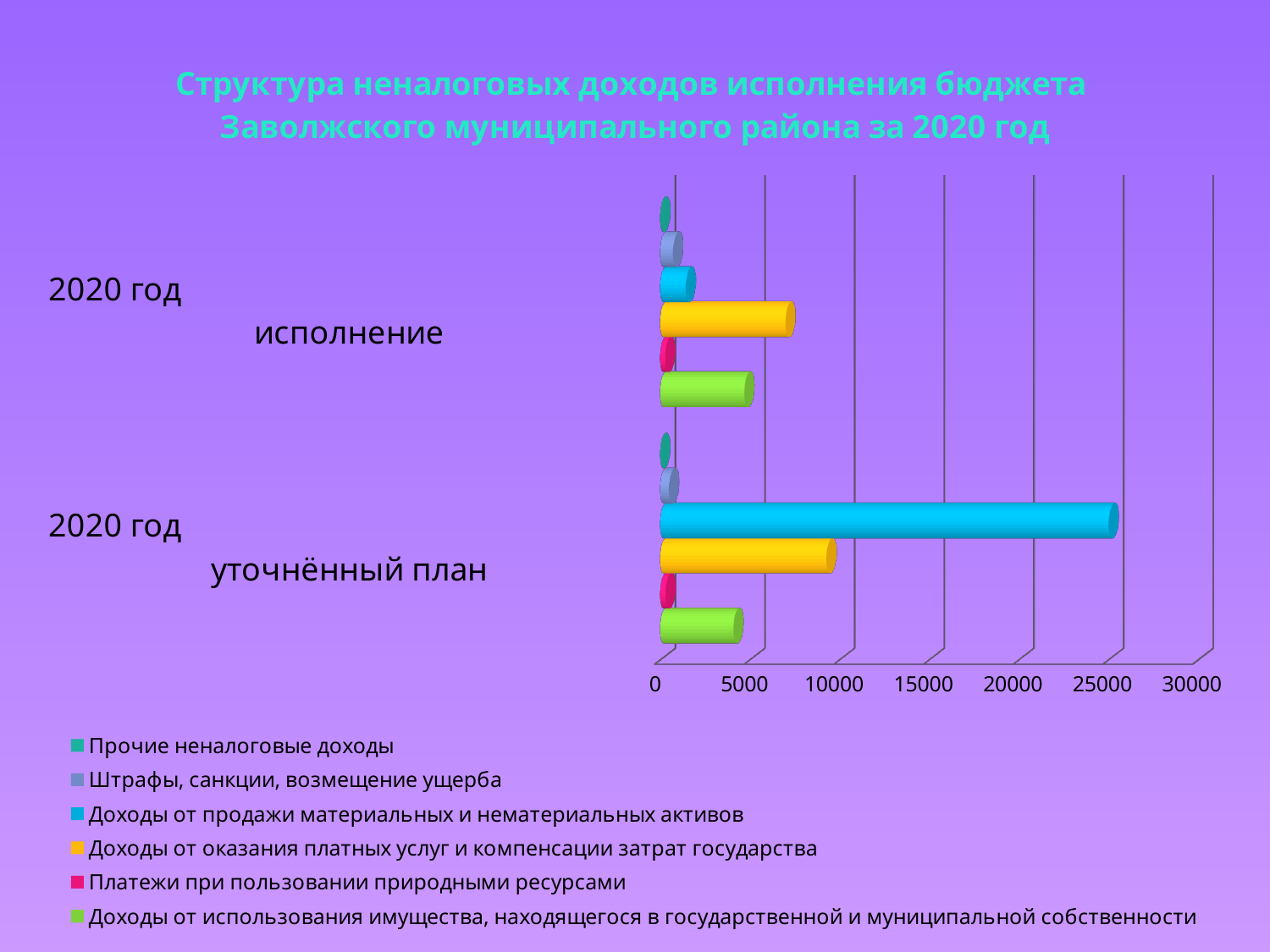
Which is larger: "Доходы от продажи материальных и нематериальных активов" for "2020 год уточнённый план" or for "2020 год исполнение"? 2020 год уточнённый план Which is larger for "2020 год исполнение": "Доходы от оказания платных услуг и компенсации затрат государства" or "Доходы от использования имущества, находящегося в государственной и муниципальной собственности"? Доходы от оказания платных услуг и компенсации затрат государства Which series has the longest bar for "2020 год уточнённый план"? Доходы от продажи материальных и нематериальных активов How many categories are shown on the vertical axis of the chart? 2 Is the value for "Доходы от оказания платных услуг и компенсации затрат государства" in "2020 год исполнение" greater or less than 10000? less What is the title of the chart? Структура неналоговых доходов исполнения бюджета Заволжского муниципального района за 2020 год Which series is shown in yellow in the legend? Доходы от оказания платных услуг и компенсации затрат государства How many series does the legend list? 6 Is the value for "Доходы от использования имущества, находящегося в государственной и муниципальной собственности" in "2020 год уточнённый план" greater or less than 5000? less Which series has the longest bar for "2020 год исполнение"? Доходы от оказания платных услуг и компенсации затрат государства Is the value for "Доходы от продажи материальных и нематериальных активов" in "2020 год уточнённый план" greater or less than 20000? greater What kind of chart is shown on the slide? bar chart